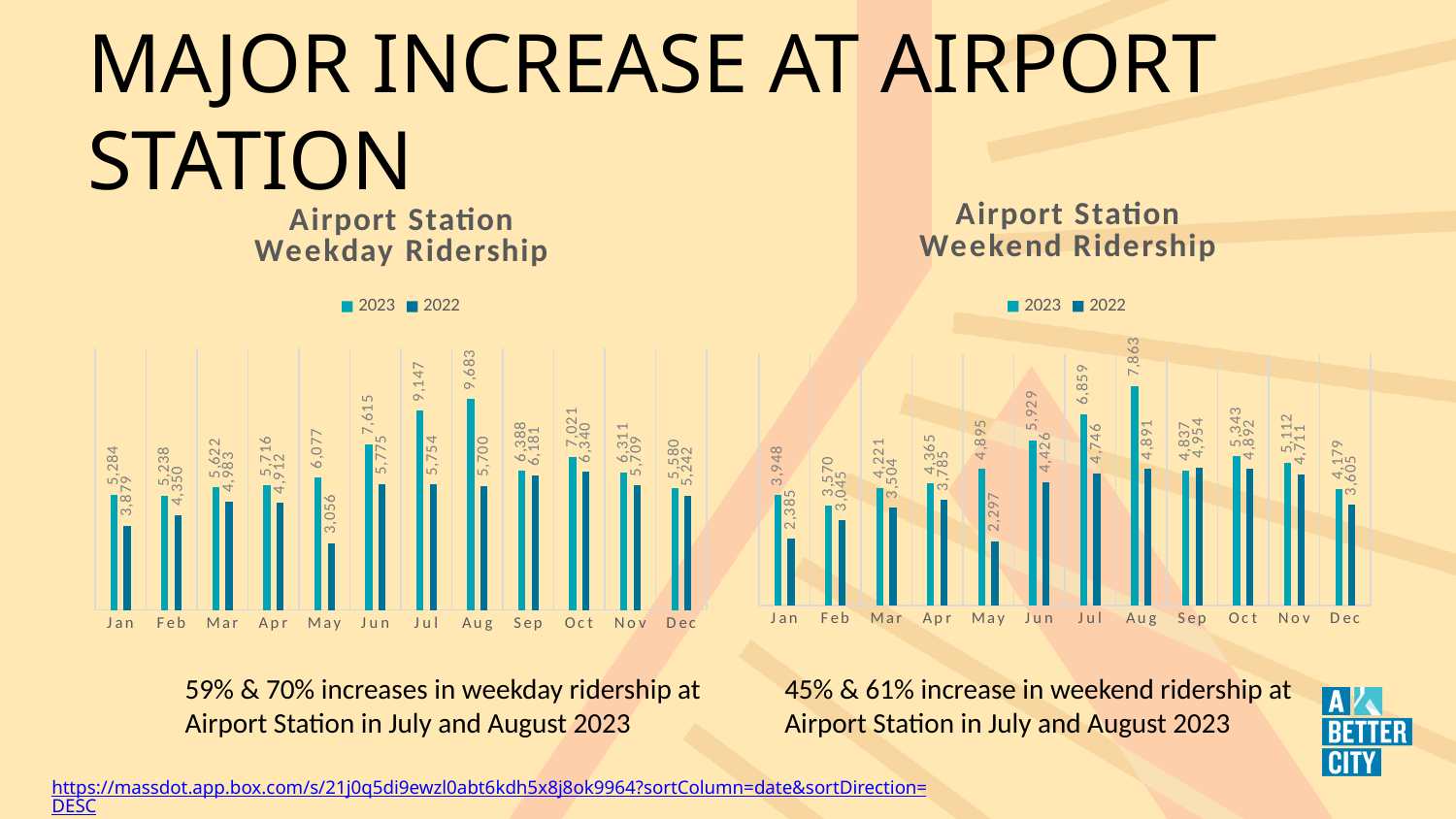
What type of chart is the Airport Station Weekday Ridership chart? Bar chart In the Airport Station Weekday Ridership chart, which month has the highest 2023 value? Aug In the Airport Station Weekday Ridership chart, what is the difference between the 2023 and 2022 values for July? 3,393 How many series does the legend of the Airport Station Weekend Ridership chart list? 2 In the Airport Station Weekend Ridership chart, which month has the lowest 2022 value? May In the Airport Station Weekend Ridership chart, what is the 2022 value for January? 2,385 In the Airport Station Weekend Ridership chart, what is the difference between the 2023 and 2022 values for August? 2,972 In the Airport Station Weekend Ridership chart, which is larger for September, the 2023 value or the 2022 value? 2022 In the Airport Station Weekday Ridership chart, what is the 2022 value for May? 3,056 In the Airport Station Weekend Ridership chart, what is the 2023 value for July? 6,859 In the Airport Station Weekday Ridership chart, what is the 2023 value for August? 9,683 How many months are shown on the x axis of the Airport Station Weekday Ridership chart? 12